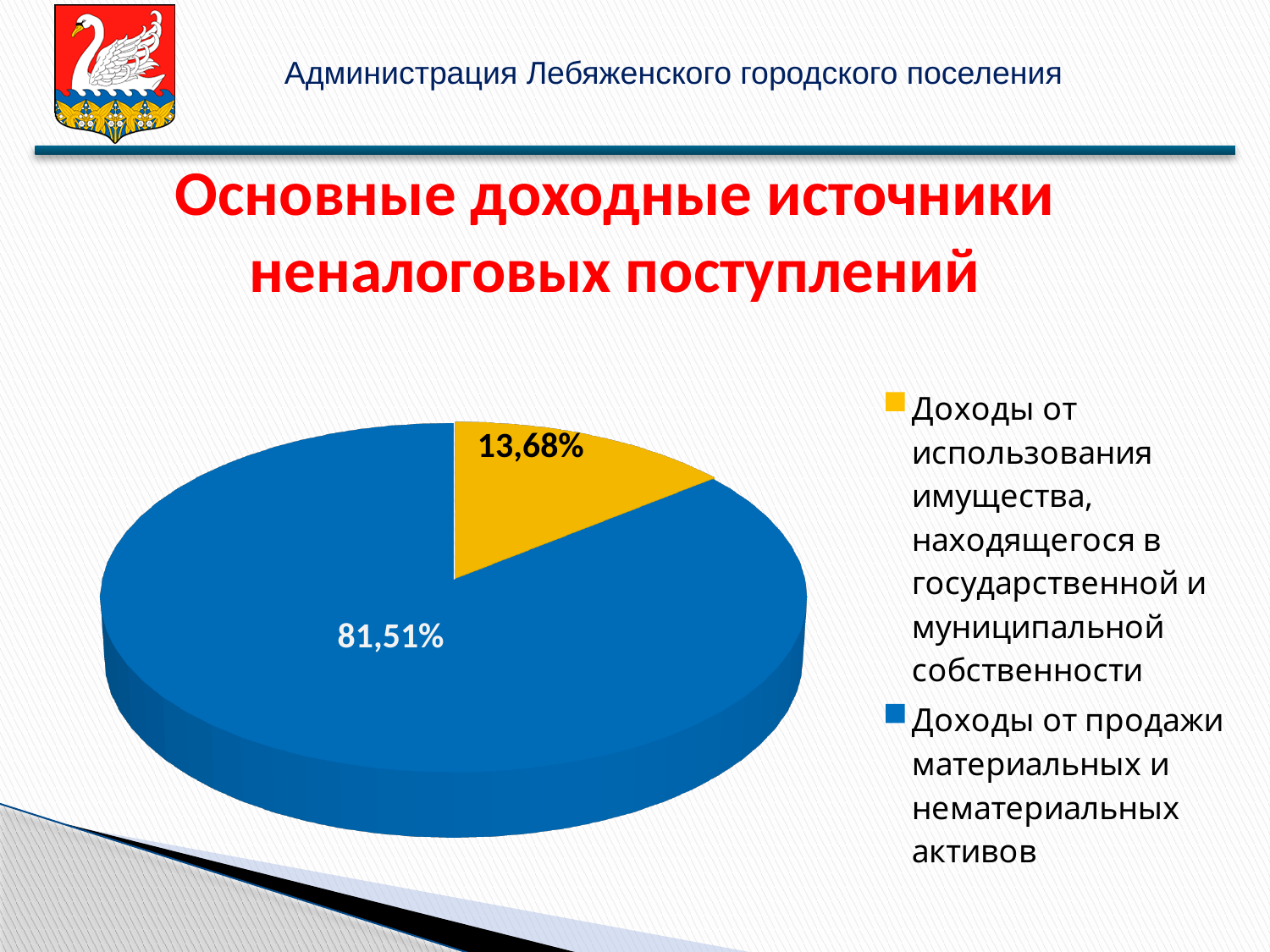
What colour is the slice for 'Доходы от продажи материальных и нематериальных активов'? Blue What kind of chart is shown on the slide? Pie chart Which is larger: the slice for 'Доходы от использования имущества' or the slice for 'Доходы от продажи материальных и нематериальных активов'? Доходы от продажи материальных и нематериальных активов What share of the pie is labelled for 'Доходы от продажи материальных и нематериальных активов'? 81,51% What colour is the slice for 'Доходы от использования имущества, находящегося в государственной и муниципальной собственности'? Yellow What is the difference in percentage points between the two labelled slices? 67,83 Which category has the smallest slice of the pie? Доходы от использования имущества, находящегося в государственной и муниципальной собственности How many slices does the pie chart have? 2 Which category has the largest slice of the pie? Доходы от продажи материальных и нематериальных активов How many entries does the legend list? 2 What share of the pie is labelled for 'Доходы от использования имущества, находящегося в государственной и муниципальной собственности'? 13,68%